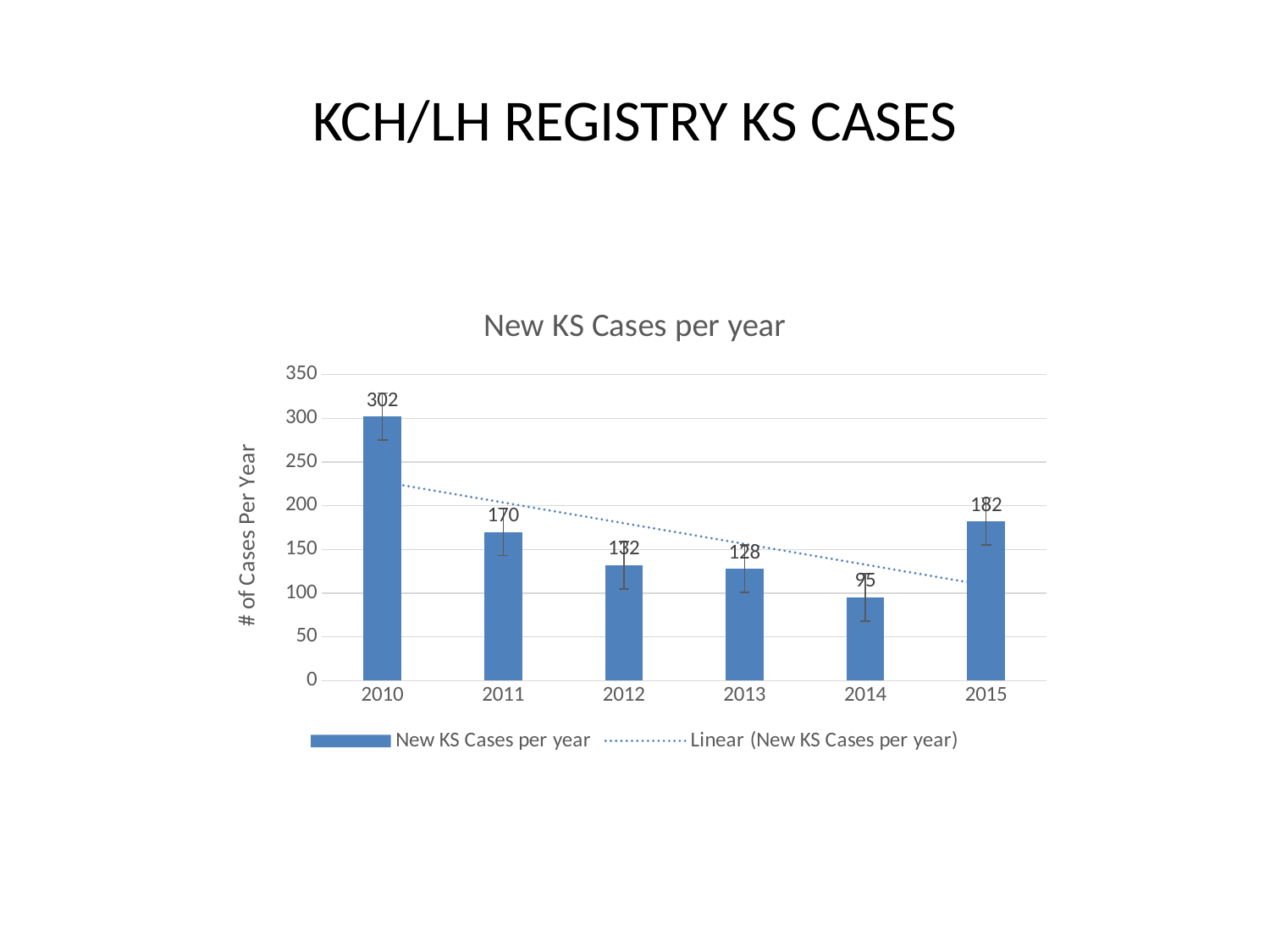
What is the number of new KS cases in 2010? 302 Is the value for 2013 greater or less than 150? less What is the number of new KS cases in 2015? 182 Which year has the lowest number of new KS cases? 2014 What is the number of new KS cases in 2014? 95 What kind of chart is used to show the new KS cases per year? bar chart How many years are shown on the x axis? 6 Which year had more new KS cases, 2011 or 2015? 2015 What is the difference in new KS cases between 2010 and 2011? 132 How many entries does the legend list? 2 What is the title of the chart? New KS Cases per year Which year has the highest number of new KS cases? 2010